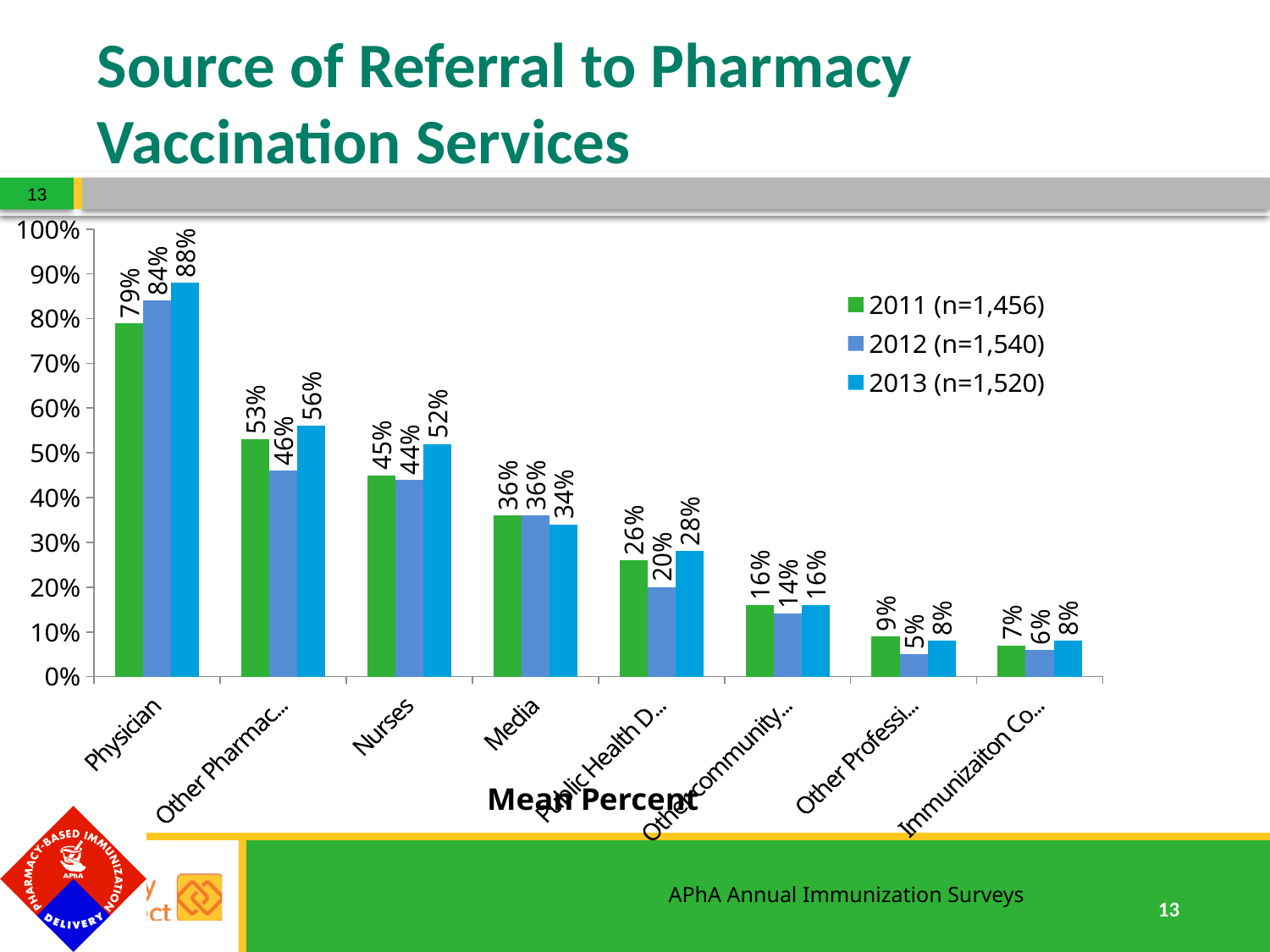
What is the value for Media in the 2012 (n=1,540) series? 36% What kind of chart is shown on the slide? bar chart What is the difference between the 2013 (n=1,520) and 2012 (n=1,540) values for Nurses? 8% Which category has the highest value in the 2012 (n=1,540) series? Physician How many series does the legend list? 3 What is the x-axis title of the chart? Mean Percent How many categories are shown on the x axis? 8 What is the difference between the 2013 (n=1,520) and 2011 (n=1,456) values for Physician? 9% Is the value for Nurses in the 2013 (n=1,520) series greater or less than 50%? greater What is the value for Physician in the 2013 (n=1,520) series? 88% What is the value for Nurses in the 2011 (n=1,456) series? 45% Which is larger for Media: the 2011 (n=1,456) value or the 2013 (n=1,520) value? 2011 (n=1,456)